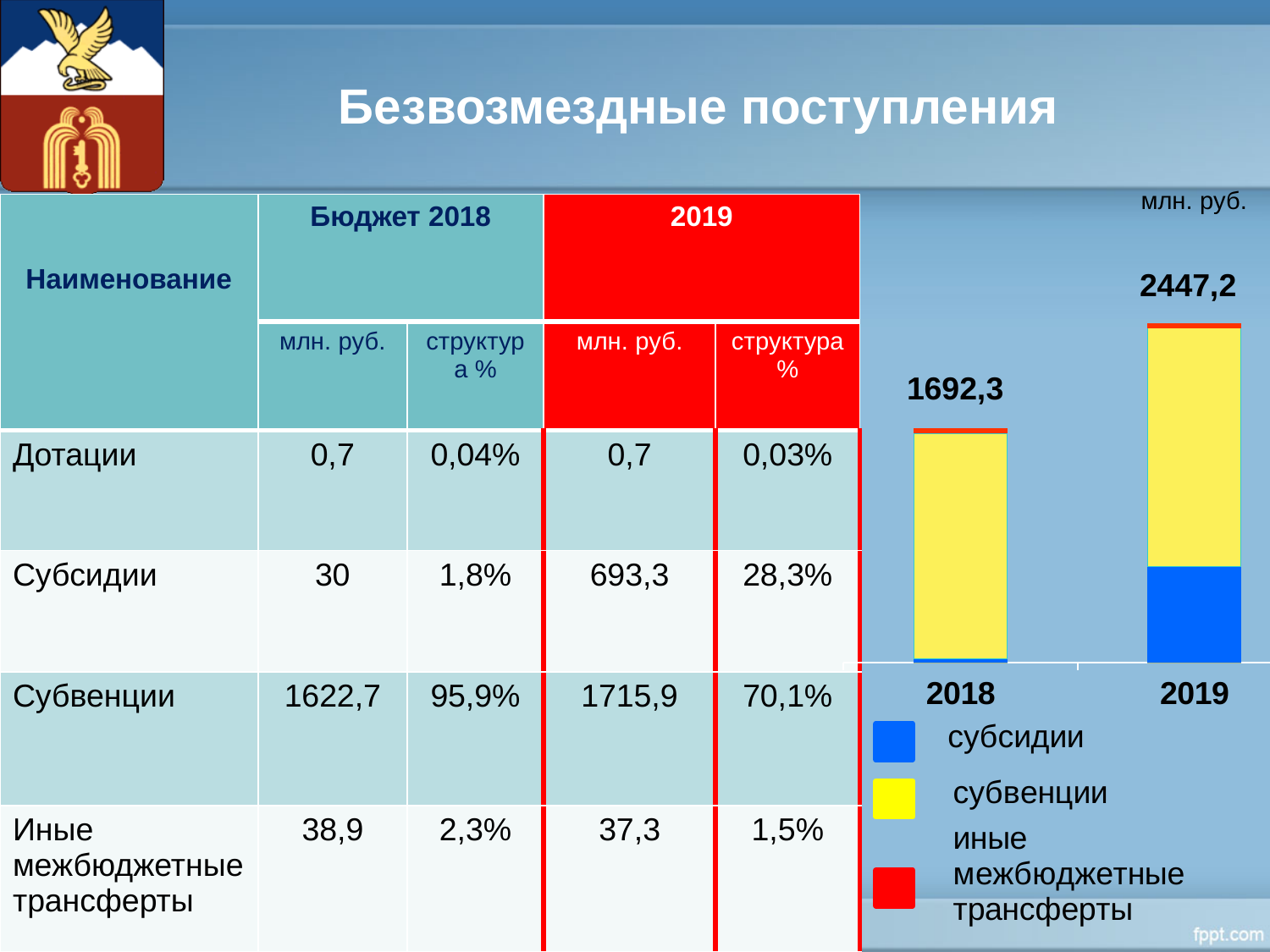
How many series does the chart legend list? 3 What is the total value shown above the bar for 2019? 2447,2 What unit is indicated in the top right corner of the chart? млн. руб. How many bars (years) are plotted in the chart? 2 Which year has the higher total of безвозмездные поступления in the chart? 2019 Which year has the lower total in the chart? 2018 Do the bar totals rise or fall from 2018 to 2019? rise Which series is shown in blue in the chart legend? субсидии What kind of chart is shown on the slide? stacked bar chart Is the total for 2018 larger or smaller than the total for 2019? smaller What is the total value shown above the bar for 2018? 1692,3 By how much does the 2019 total exceed the 2018 total? 754,9